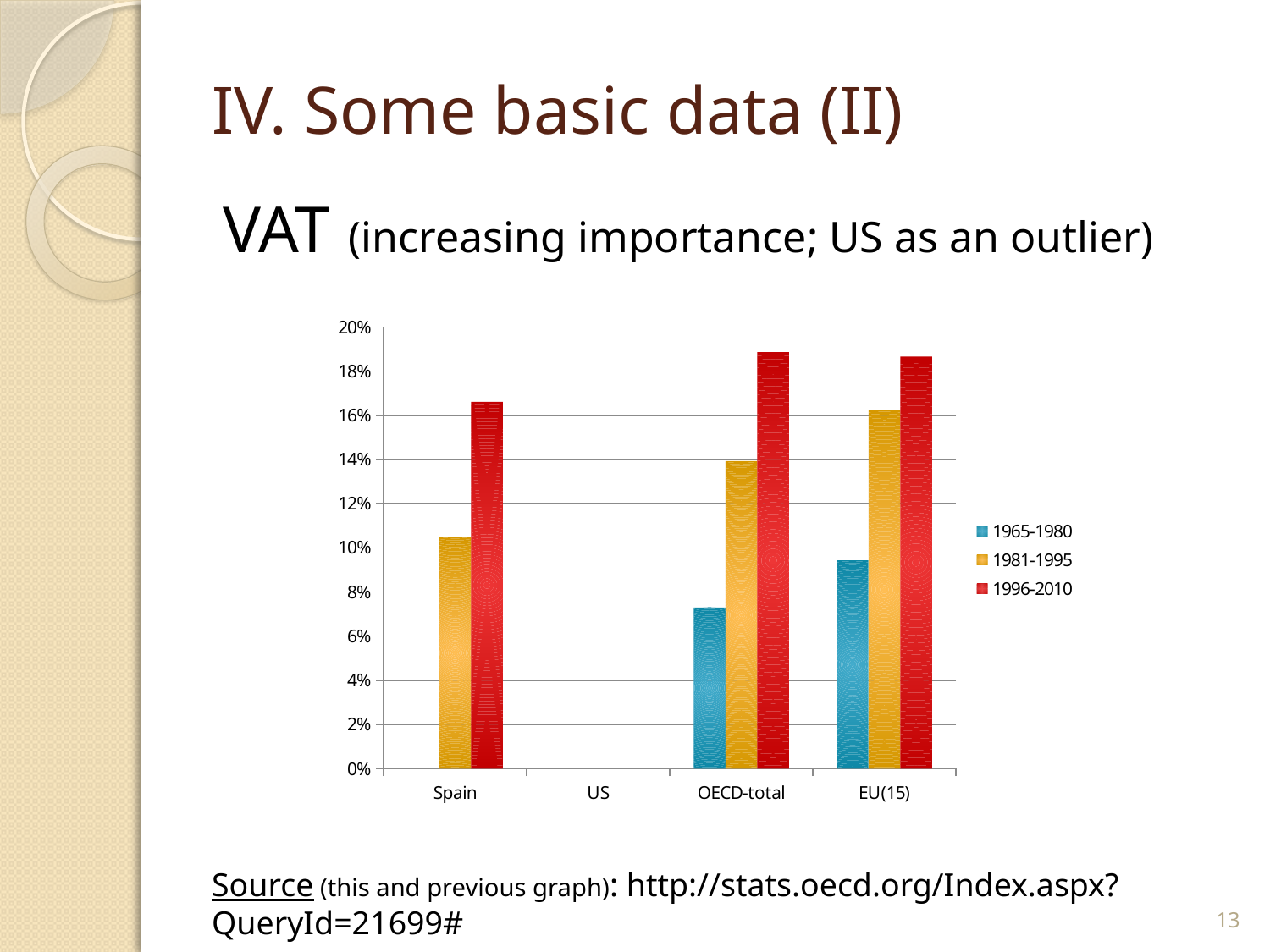
How many series does the chart's legend list? 3 Is the value for OECD-total in the 1965-1980 series greater or less than 8%? less Is the value for OECD-total in the 1981-1995 series greater or less than 12%? greater Which category has the lowest non-zero value for the 1965-1980 series? OECD-total Which category has the highest value for the 1981-1995 series? EU(15) Which is larger for the 1996-2010 series: Spain or EU(15)? EU(15) Which category on the chart has no visible bars for any series? US What kind of chart is shown on the slide? bar chart How many categories are shown on the x axis of the chart? 4 Within each category that has bars, do the values rise or fall from the 1965-1980 period to the 1996-2010 period? rise Is the value for EU(15) in the 1965-1980 series greater or less than 10%? less